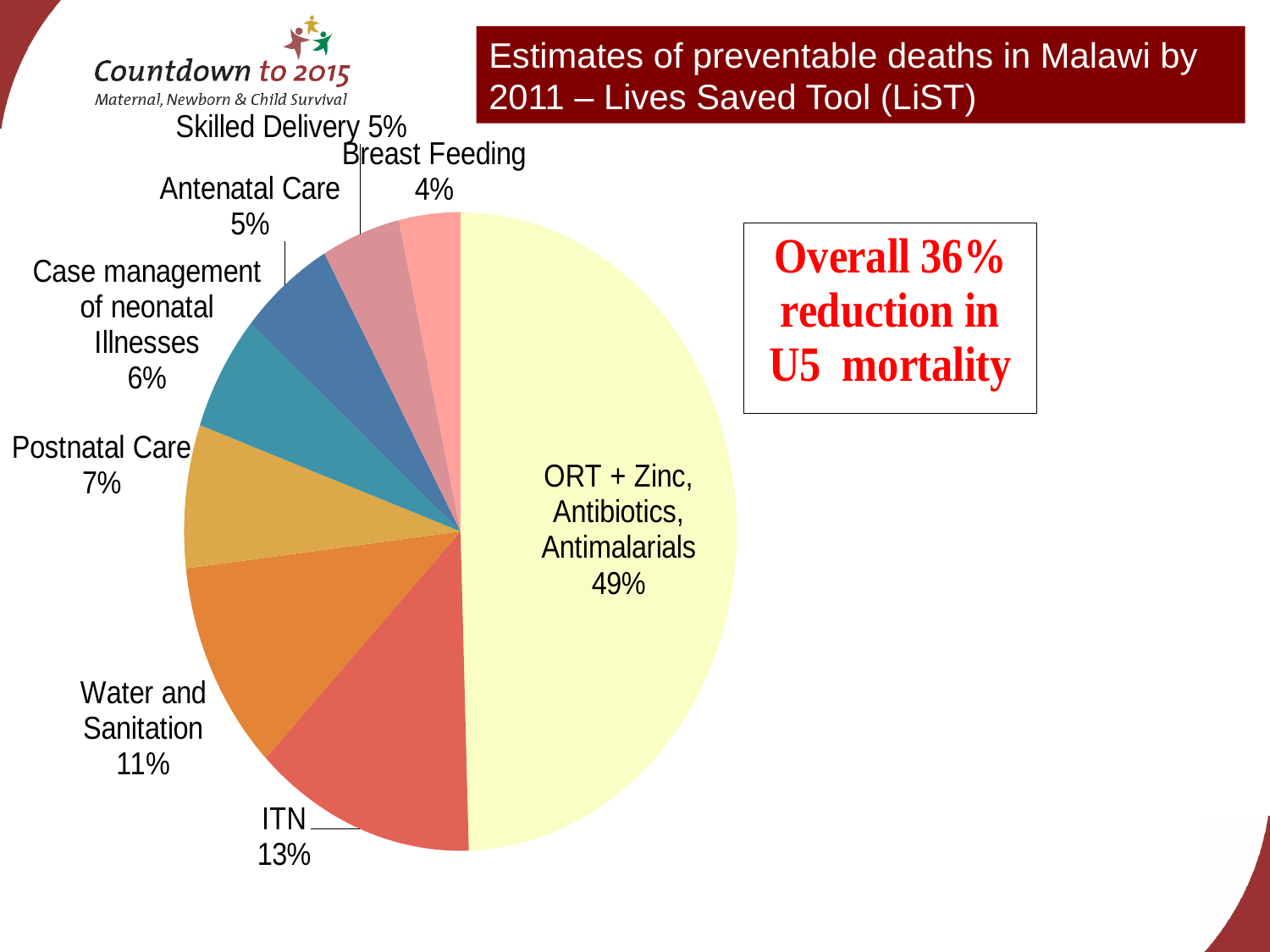
What percentage is shown for Water and Sanitation? 11% How many categories are shown in the pie chart? 8 What percentage is shown for Postnatal Care? 7% What percentage is shown for Case management of neonatal Illnesses? 6% What is the difference in percentage points between ITN and Water and Sanitation? 2 Which category has the largest slice of the pie? ORT + Zinc, Antibiotics, Antimalarials What percentage is shown for Breast Feeding? 4% Which category has the smallest slice of the pie? Breast Feeding What share of preventable deaths is attributed to ORT + Zinc, Antibiotics, Antimalarials? 49% What percentage is shown for ITN? 13% Which is larger, the share for Postnatal Care or the share for Antenatal Care? Postnatal Care What type of chart is shown on the slide? Pie chart